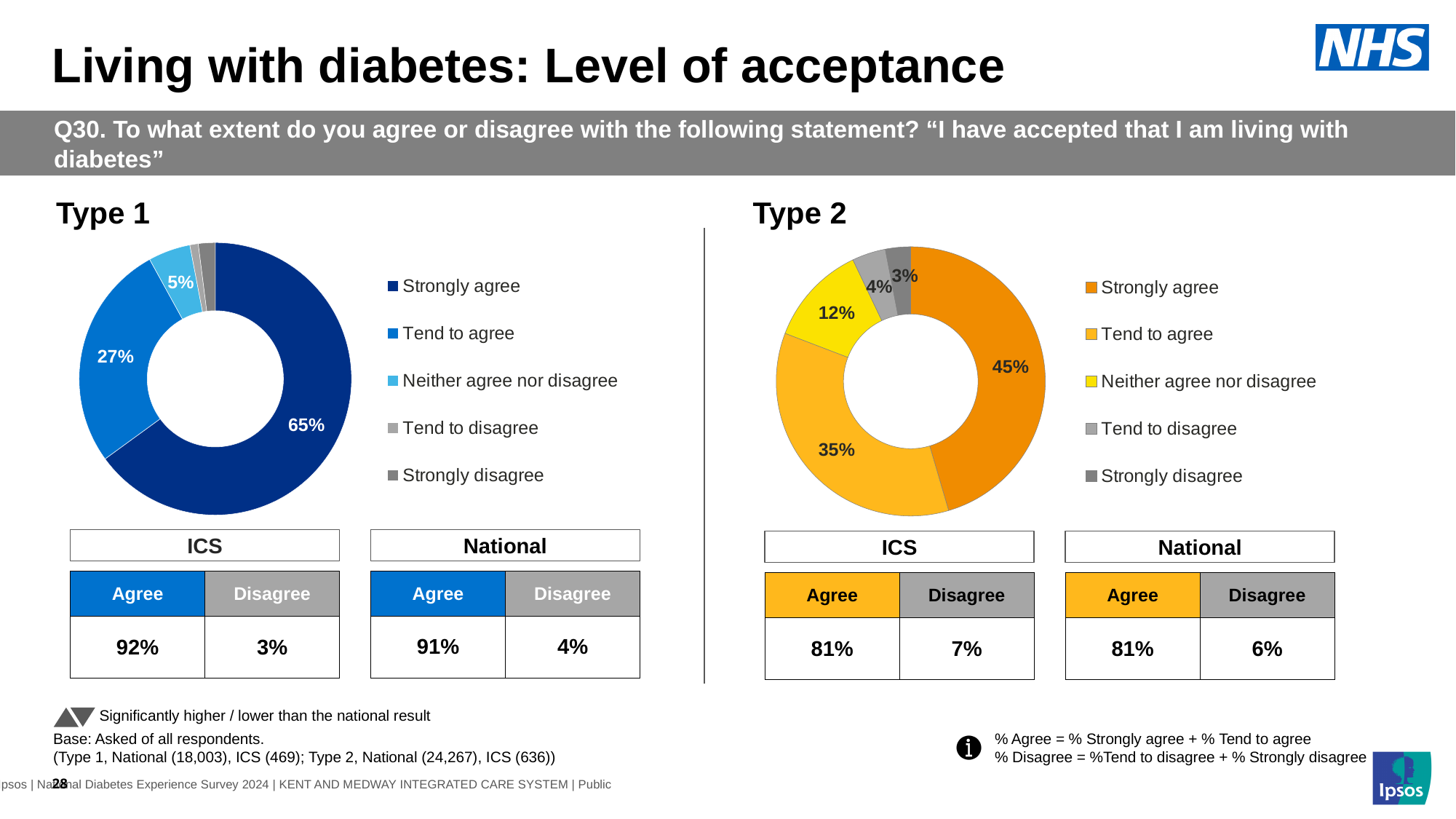
In the Type 2 chart, what percentage of respondents neither agree nor disagree? 12% Which chart has a larger Strongly agree share, Type 1 or Type 2? Type 1 In the Type 1 chart, what percentage of respondents strongly agree? 65% In the Type 2 chart, what percentage of respondents strongly agree? 45% How many series does the legend of the Type 2 chart list? 5 In the Type 2 chart, which labelled response category has the smallest share? Strongly disagree In the Type 2 chart, what percentage of respondents strongly disagree? 3% In the Type 1 chart, what percentage of respondents tend to agree? 27% In the Type 1 chart, which response category has the largest share? Strongly agree In the Type 1 chart, what colour represents Strongly agree? Dark blue In the Type 2 chart, what is the difference between the Strongly agree and Tend to agree shares? 10% What kind of chart is used for Type 1? Donut chart